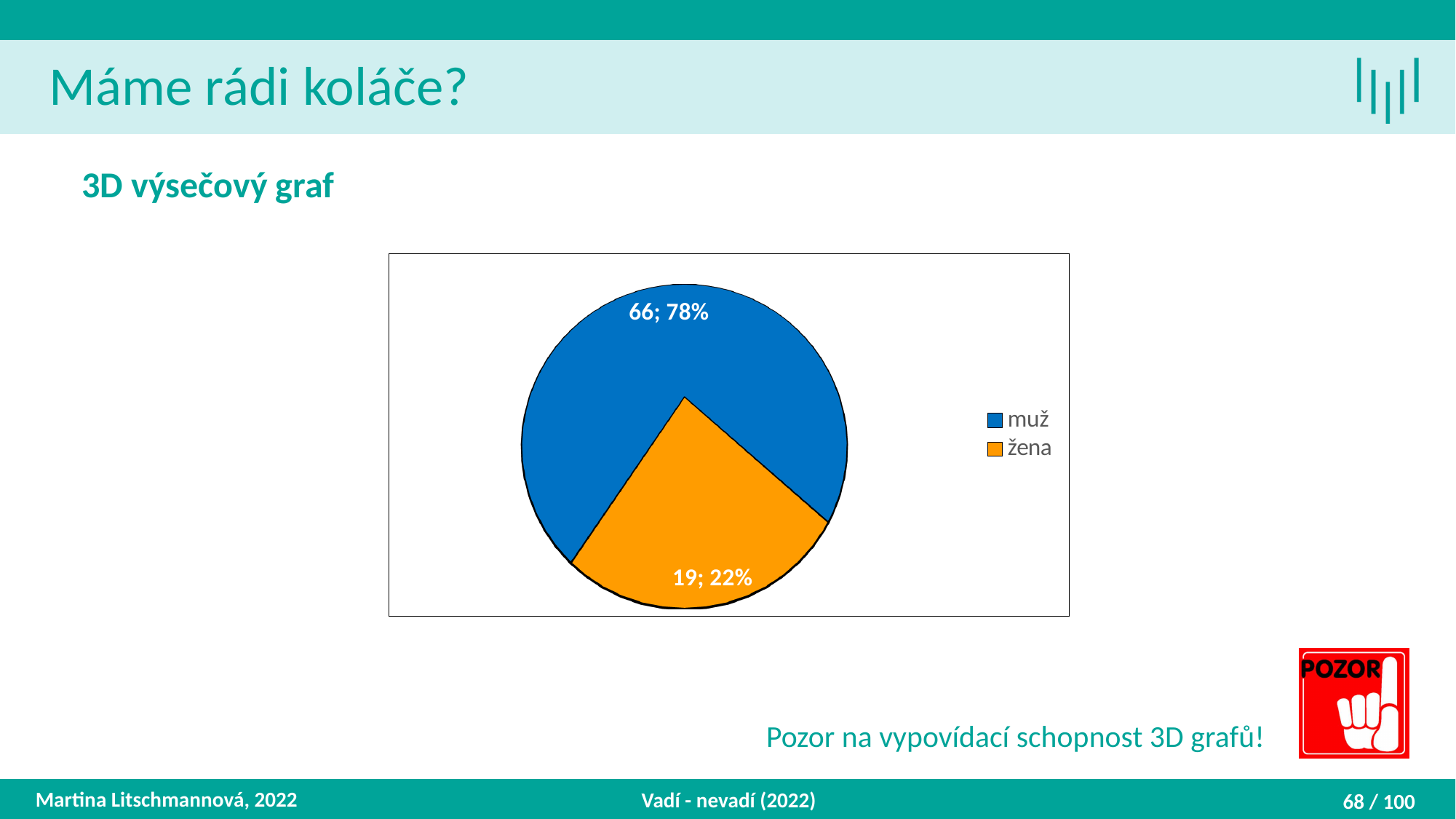
Which is larger, the value for muž or the value for žena? muž What is the difference between the counts for muž and žena? 47 What percentage share does the žena slice have? 22% Which category has the largest slice? muž What is the count value for muž? 66 How many categories does the pie chart have? 2 What kind of chart is shown on the slide? pie chart What is the count value for žena? 19 What percentage share does the muž slice have? 78% Which category has the smallest slice? žena What colour is the žena slice? orange What is the total of the two counts shown in the pie chart? 85